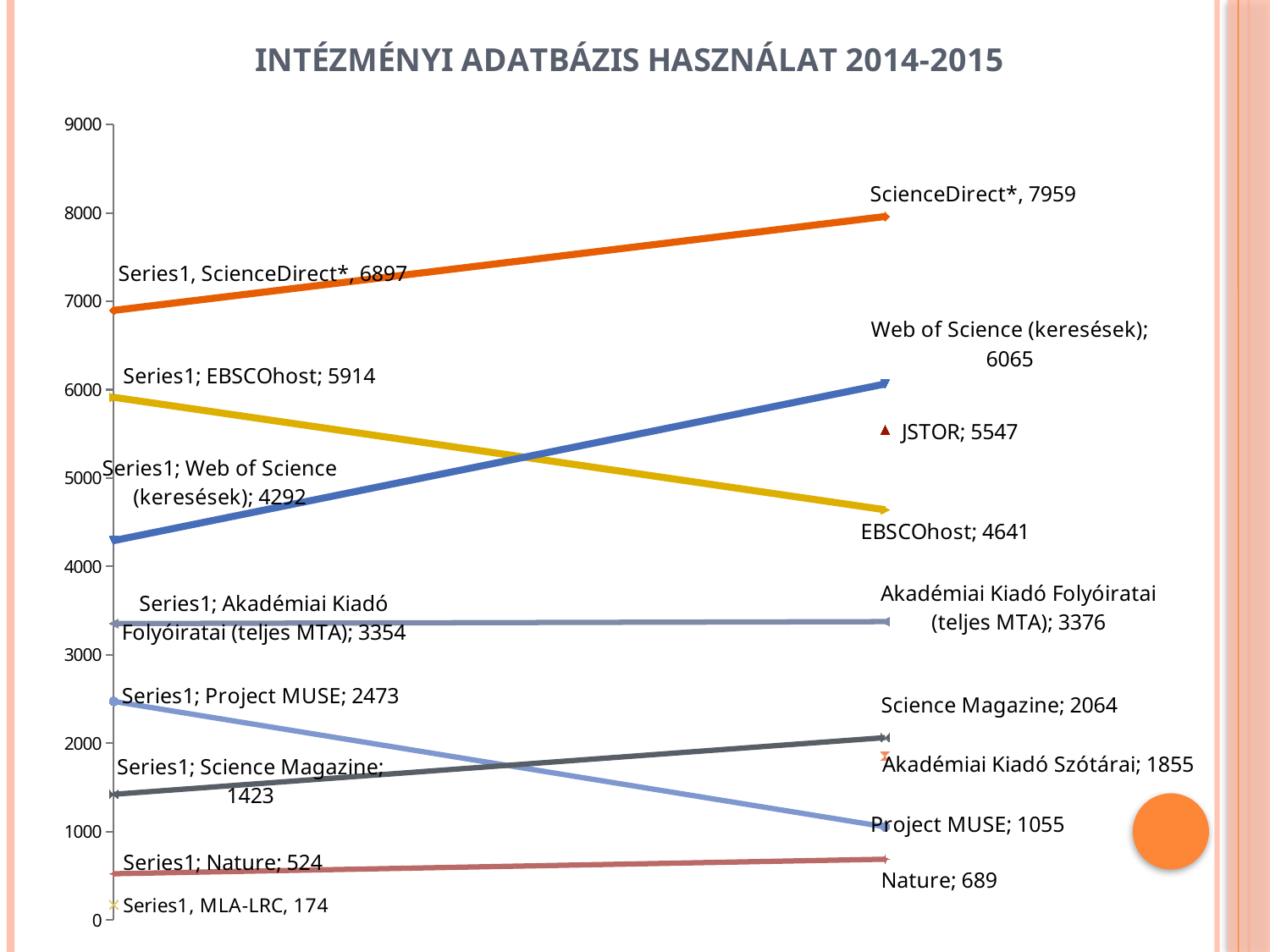
Which is larger at the right-hand end: Science Magazine or Project MUSE? Science Magazine Which database has the highest value at the right-hand end of the chart? ScienceDirect* Does the EBSCOhost line rise or fall from left to right? fall By how much did the ScienceDirect* value increase from its starting label (6897) to its end label (7959)? 1062 What is the title of the chart? INTÉZMÉNYI ADATBÁZIS HASZNÁLAT 2014-2015 What value is labelled for JSTOR? 5547 What kind of chart is shown on the slide? line chart What is the starting (left-hand) value labelled for Web of Science (keresések)? 4292 What is the starting (left-hand) value labelled for ScienceDirect*? 6897 What is the end (right-hand) value labelled for ScienceDirect*? 7959 What is the end (right-hand) value labelled for EBSCOhost? 4641 Which database has the lowest labelled value at the left-hand start of the chart? MLA-LRC